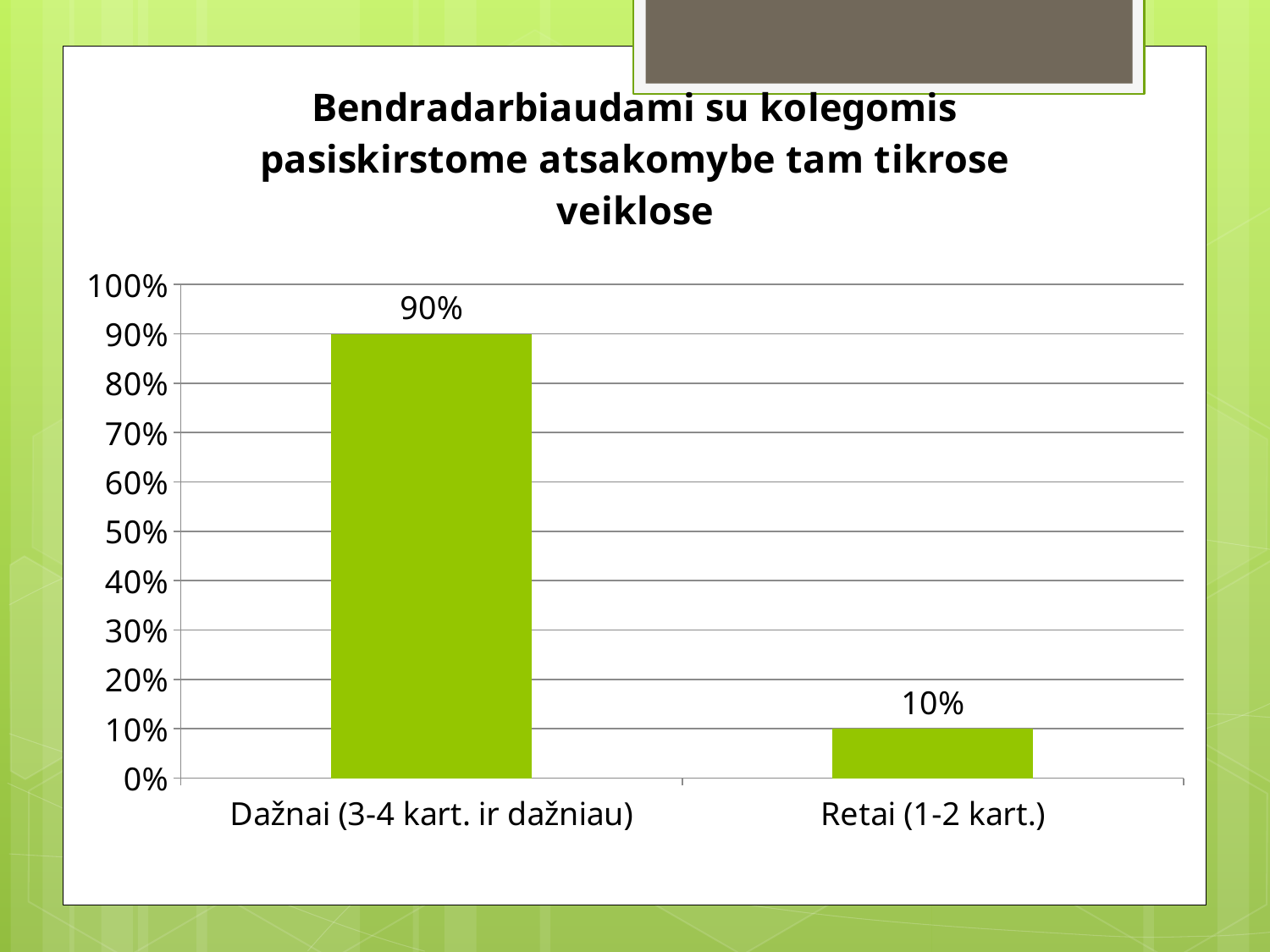
Which category has the lowest value? Retai (1-2 kart.) Which is larger, the value for Dažnai (3-4 kart. ir dažniau) or the value for Retai (1-2 kart.)? Dažnai (3-4 kart. ir dažniau) What kind of chart is shown on the slide? bar chart What is the value for Retai (1-2 kart.)? 10% What is the value for Dažnai (3-4 kart. ir dažniau)? 90% Is the value for Retai (1-2 kart.) greater or less than 50%? less What is the title of the chart? Bendradarbiaudami su kolegomis pasiskirstome atsakomybe tam tikrose veiklose Which category has the highest value? Dažnai (3-4 kart. ir dažniau) How many categories are shown on the x axis? 2 What is the difference between the values for Dažnai (3-4 kart. ir dažniau) and Retai (1-2 kart.)? 80% Do the values rise or fall from left to right along the x axis? fall What is the maximum value shown on the y axis? 100%